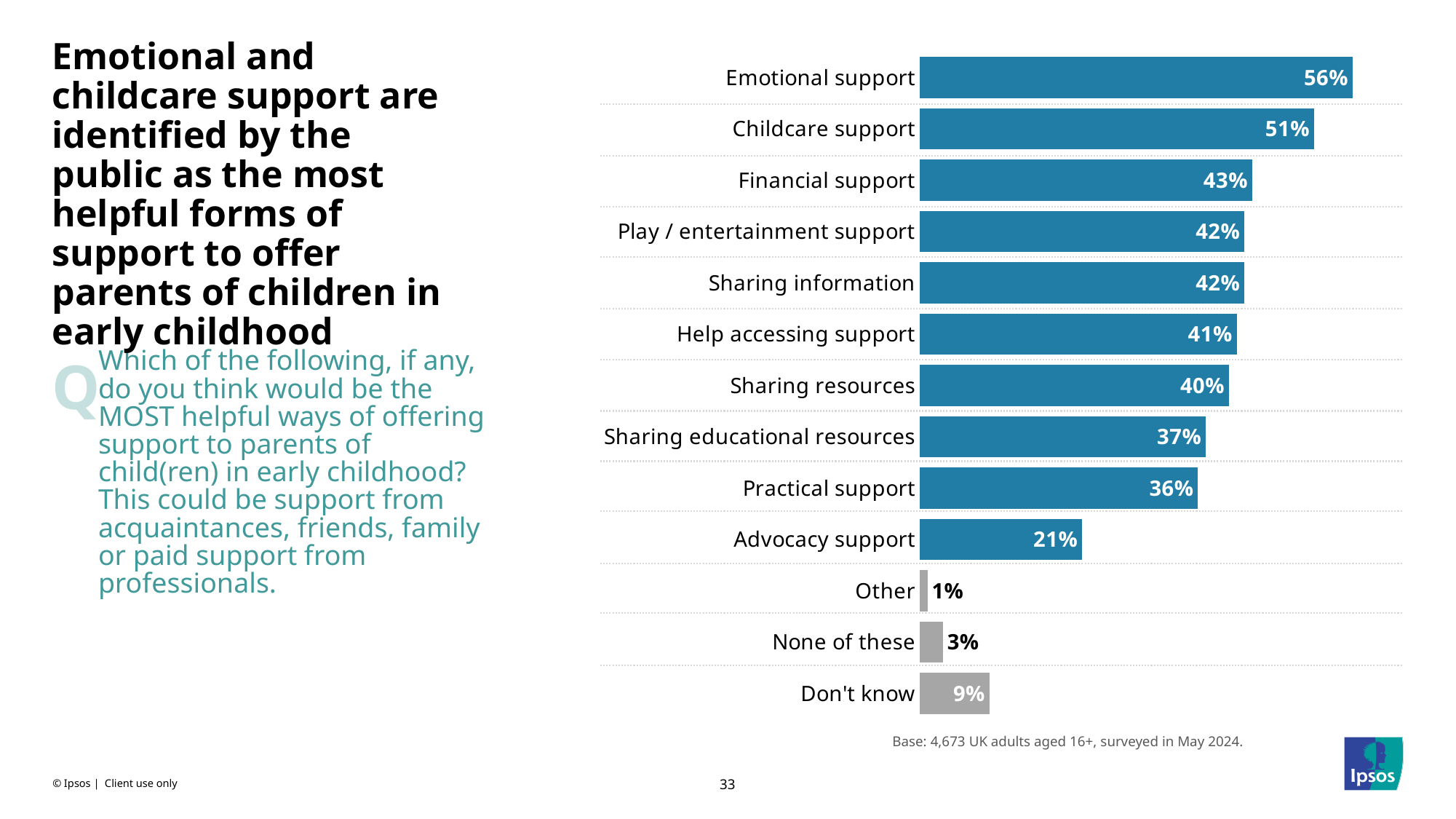
Which category has the highest value on the chart? Emotional support Which is larger, the value for Sharing resources or the value for Sharing educational resources? Sharing resources Which categories are shown with grey bars rather than blue bars? Other, None of these, Don't know How many categories are shown on the chart? 13 Which is larger, the value for None of these or the value for Don't know? Don't know What is the difference between the values for Financial support and Practical support? 7% Which category has the lowest value on the chart? Other What percentage of respondents selected Emotional support? 56% What is the value shown for Advocacy support? 21% What percentage of respondents answered Don't know? 9% What type of chart is shown on the slide? Bar chart What is the difference between the values for Emotional support and Childcare support? 5%